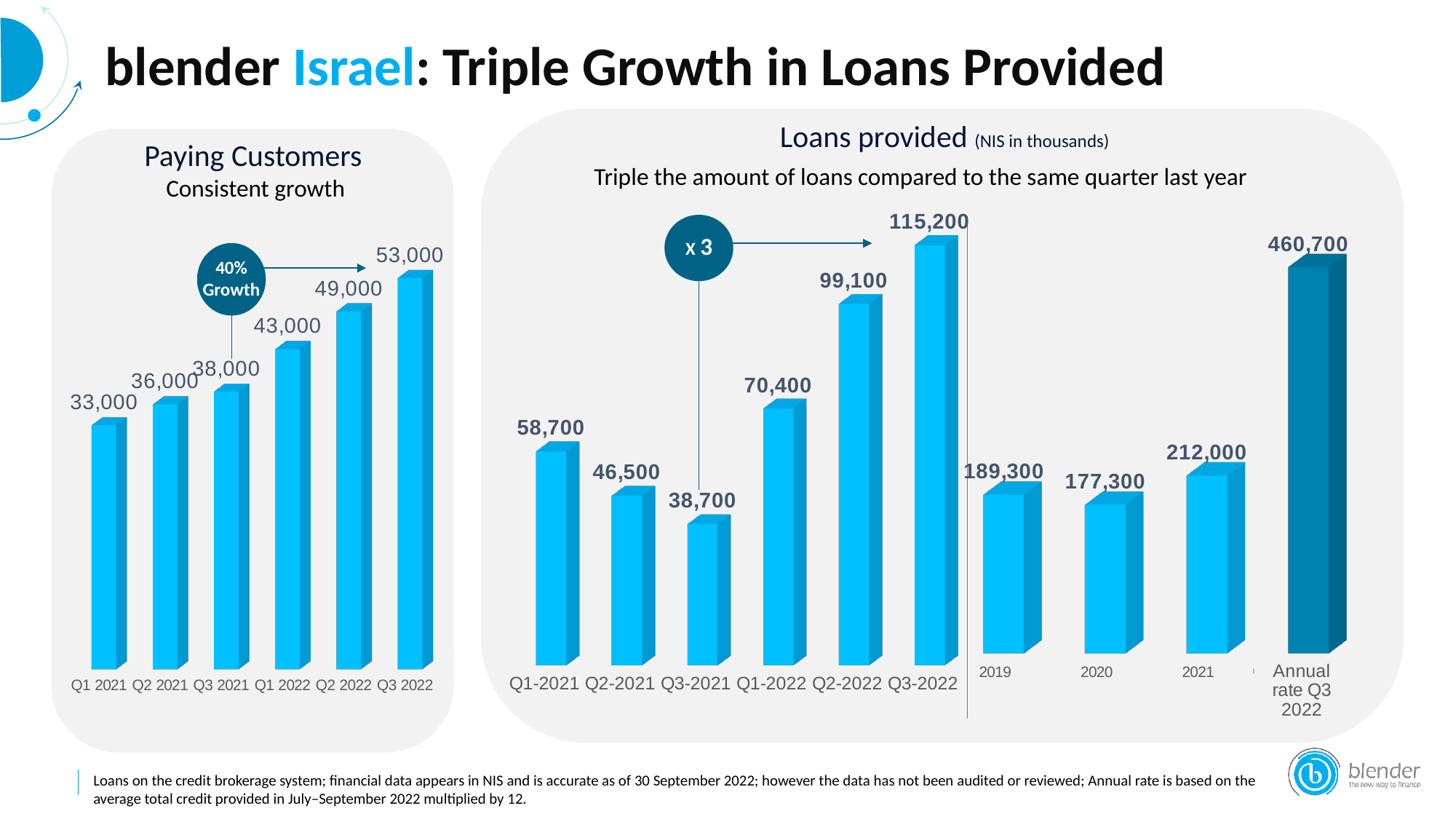
What kind of chart is the Loans provided chart? bar chart In the Loans provided chart, what is the value for the Annual rate Q3 2022 bar? 460,700 In the Paying Customers chart, what is the value for Q3 2022? 53,000 In the Paying Customers chart, how many quarters are plotted? 6 In the Paying Customers chart, what is the value for Q1 2021? 33,000 In the Paying Customers chart, what is the difference between Q3 2022 and Q1 2021? 20,000 In the Loans provided chart, which quarter has the lowest value? Q3-2021 In the Loans provided chart, what is the value for Q3-2022? 115,200 In the Loans provided chart, which is larger, the value for 2020 or the value for 2021? 2021 In the Loans provided chart, what is the difference between the 2021 value and the 2020 value? 34,700 In the Paying Customers chart, do the values rise or fall from Q1 2021 to Q3 2022? rise In the Loans provided chart, what is the value for Q3-2021? 38,700